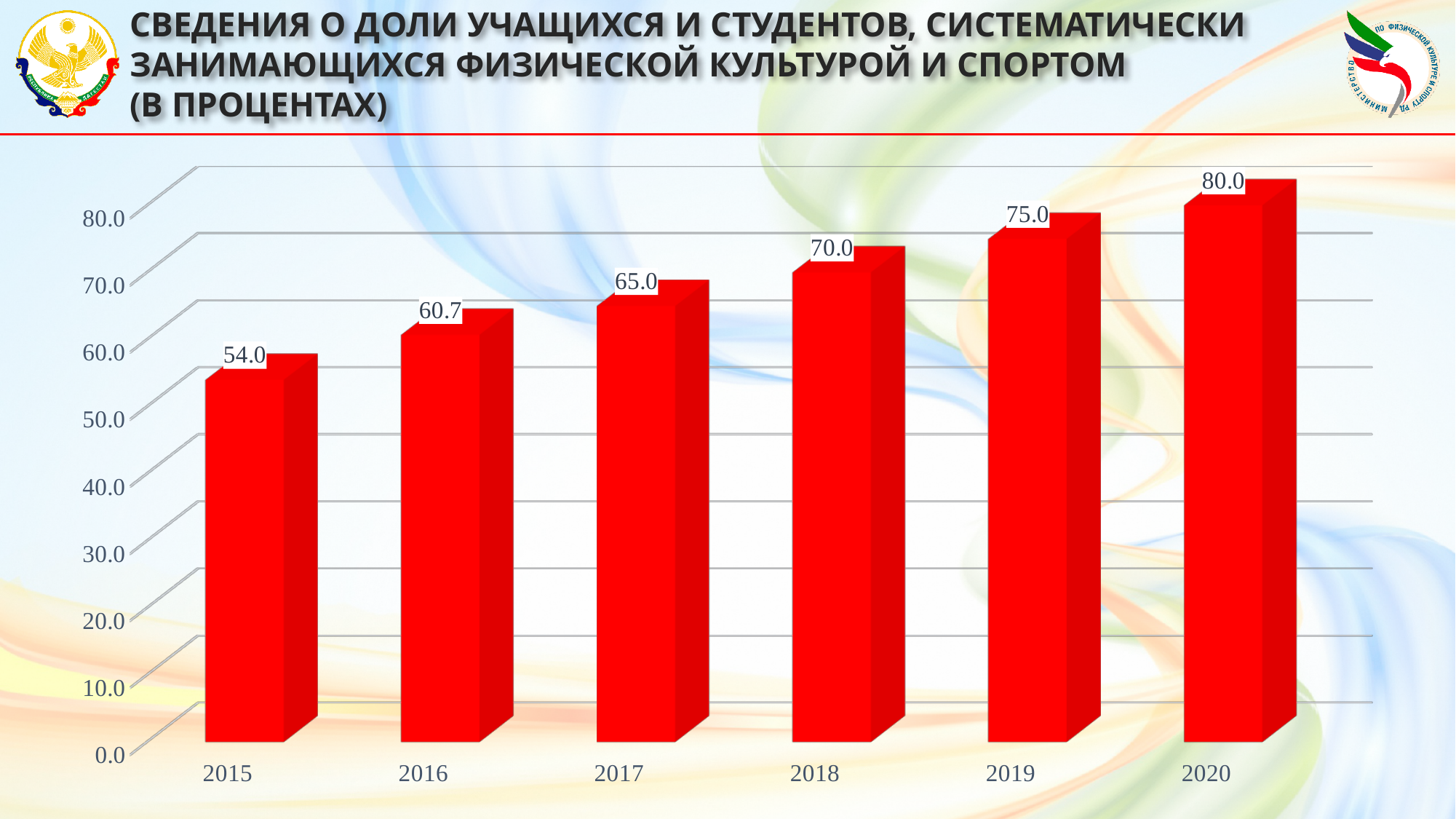
What is the value for 2015? 54.0 Which year has the lowest value? 2015 What is the difference between the values for 2017 and 2016? 4.3 Which is larger, the value for 2019 or the value for 2017? 2019 Which year has the highest value? 2020 How many years are shown on the x axis? 6 What is the difference between the values for 2020 and 2015? 26.0 What kind of chart is shown on the slide? bar chart What is the value for 2016? 60.7 What is the value for 2018? 70.0 Is the value for 2016 greater or less than 70.0? less Do the values rise or fall from 2015 to 2020? rise